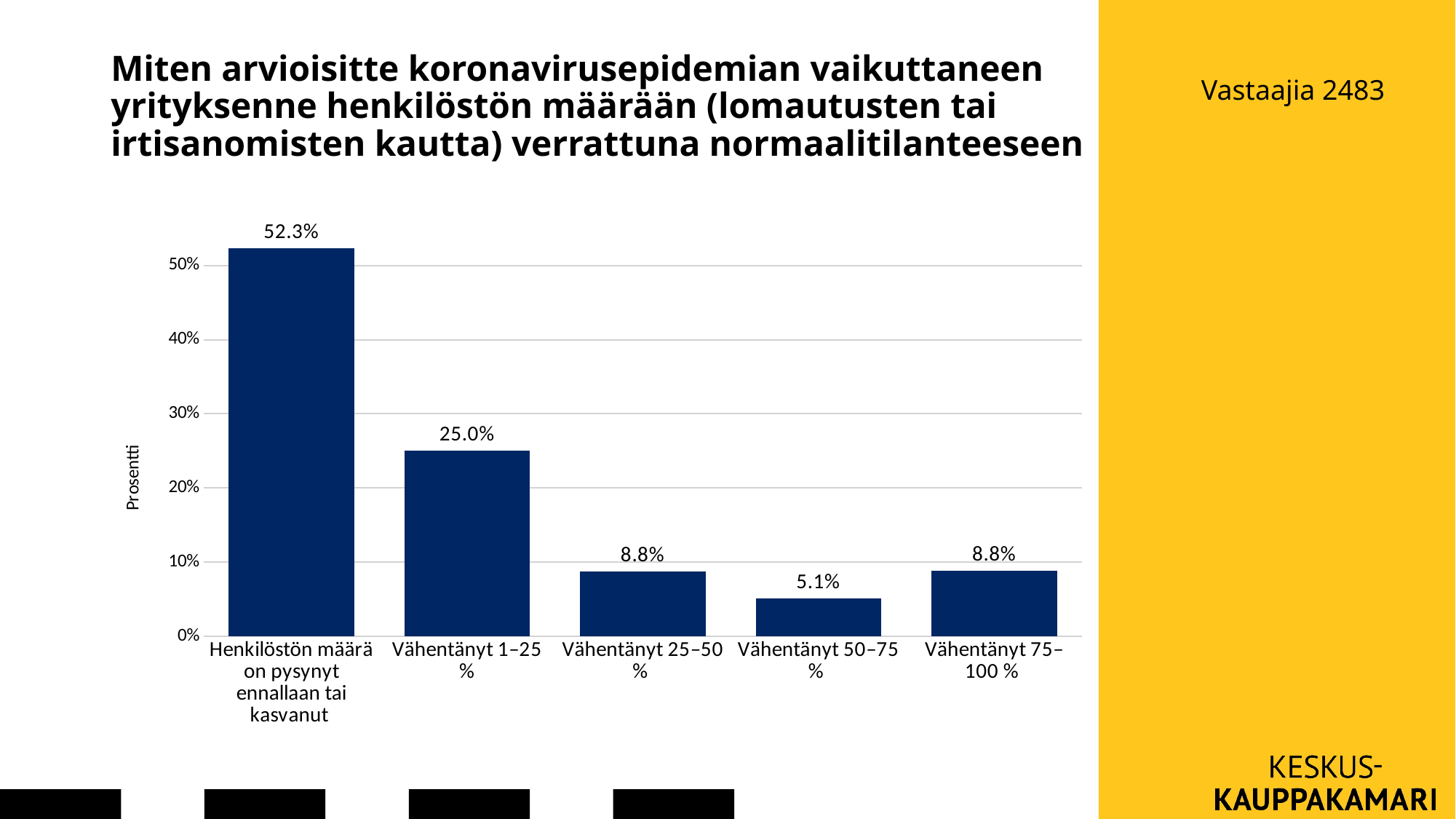
What is the label of the vertical axis? Prosentti What is the value for 'Vähentänyt 50–75 %'? 5.1% How many categories are shown on the x axis? 5 Is the value for 'Vähentänyt 25–50 %' greater or less than 10%? less What is the value for 'Henkilöstön määrä on pysynyt ennallaan tai kasvanut'? 52.3% What is the value for 'Vähentänyt 1–25 %'? 25.0% Which is larger, the value for 'Vähentänyt 1–25 %' or 'Vähentänyt 25–50 %'? Vähentänyt 1–25 % What is the difference between the values for 'Henkilöstön määrä on pysynyt ennallaan tai kasvanut' and 'Vähentänyt 1–25 %'? 27.3% Which category has the lowest value? Vähentänyt 50–75 % Which category has the highest value? Henkilöstön määrä on pysynyt ennallaan tai kasvanut What kind of chart is shown on the slide? bar chart What is the value for 'Vähentänyt 75–100 %'? 8.8%